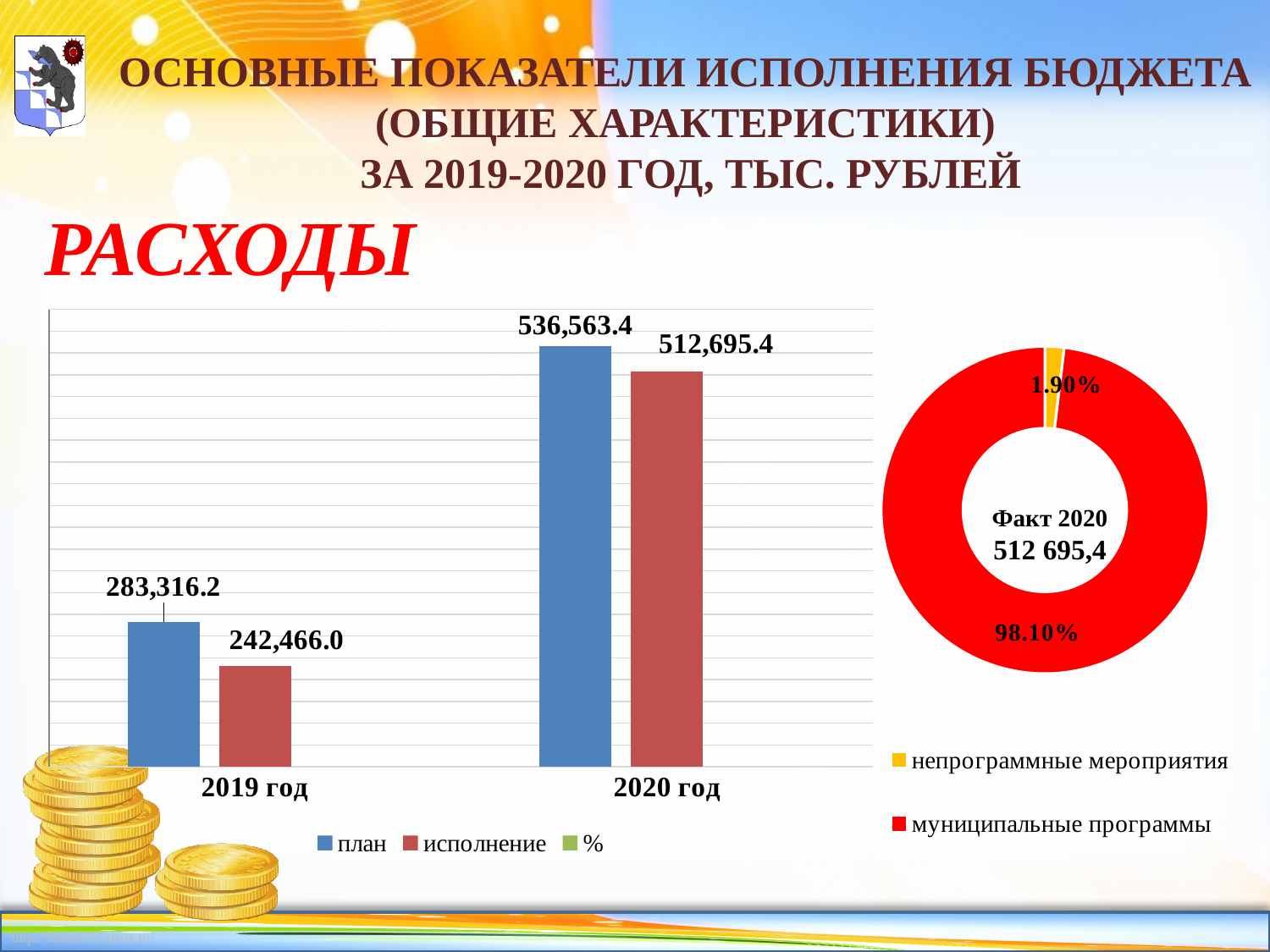
In the bar chart on the left, what is the value of исполнение for 2020 год? 512,695.4 In the bar chart on the left, what is the value of план for 2019 год? 283,316.2 In the doughnut chart on the right, what share is муниципальные программы? 98.10% In the doughnut chart on the right, what share is непрограммные мероприятия? 1.90% In the bar chart on the left, what is the difference between план and исполнение for 2020 год? 23,868.0 In the bar chart on the left, what is the difference between план and исполнение for 2019 год? 40,850.2 In the bar chart on the left, which bar is the highest? план, 2020 год In the bar chart on the left, how many series does the legend list? 3 In the bar chart on the left, what is the value of исполнение for 2019 год? 242,466.0 In the bar chart on the left, which is larger: план for 2019 год or исполнение for 2020 год? исполнение for 2020 год In the bar chart on the left, which bar is the lowest? исполнение, 2019 год In the bar chart on the left, do the values of план rise or fall from 2019 год to 2020 год? rise